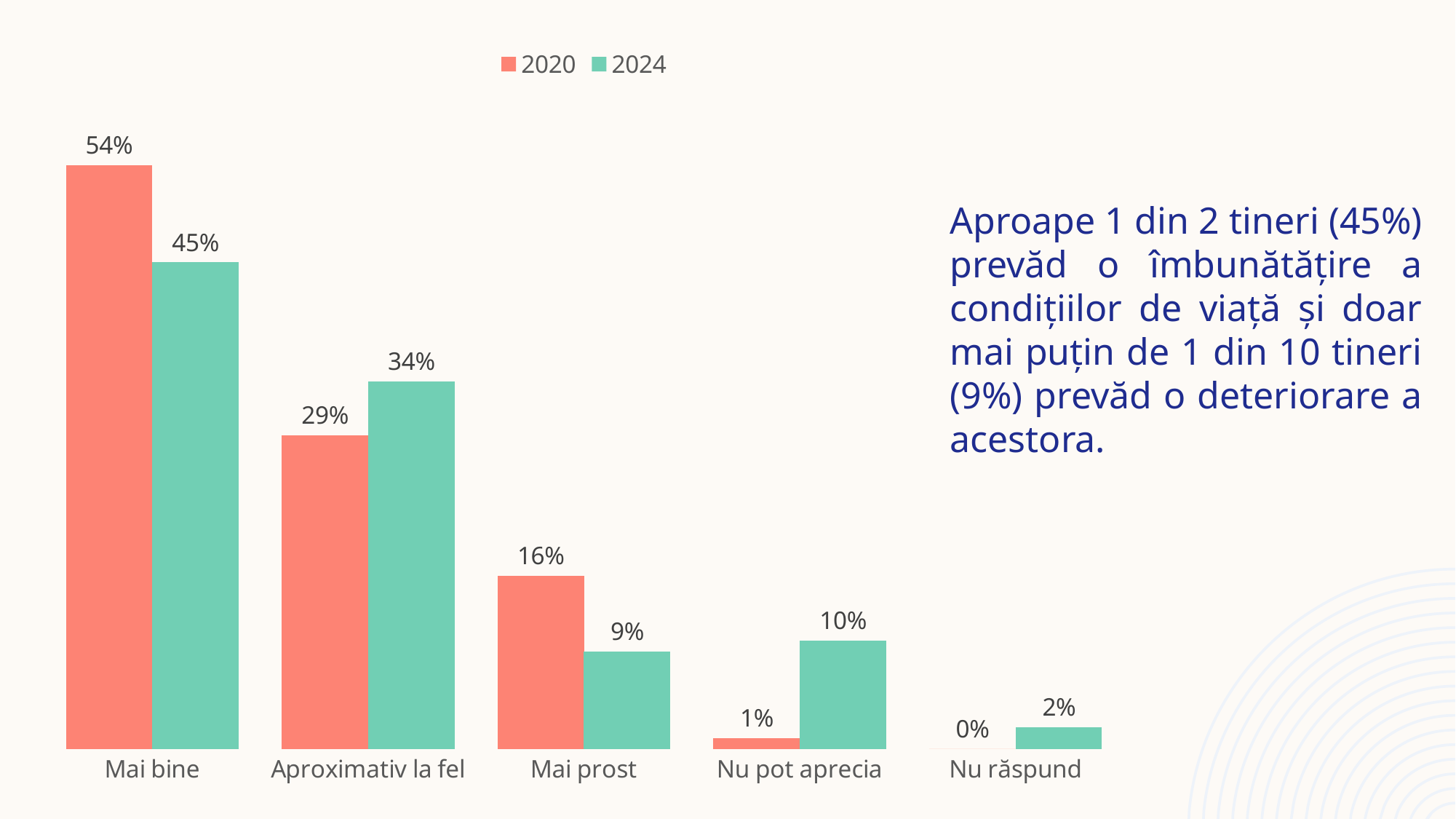
What is the value for "Nu pot aprecia" in the 2020 series? 1% What is the value for "Mai bine" in the 2020 series? 54% Which category has the highest value in the 2024 series? Mai bine How many series does the legend list? 2 What is the difference between the 2020 and 2024 values for "Mai bine"? 9% What is the value for "Mai prost" in the 2024 series? 9% What kind of chart is shown on the slide? Bar chart Which category has the lowest value in the 2020 series? Nu răspund What is the value for "Aproximativ la fel" in the 2024 series? 34% Which is larger for "Aproximativ la fel": the 2020 value or the 2024 value? 2024 How many categories are shown on the x axis? 5 Which series is shown in green in the legend? 2024